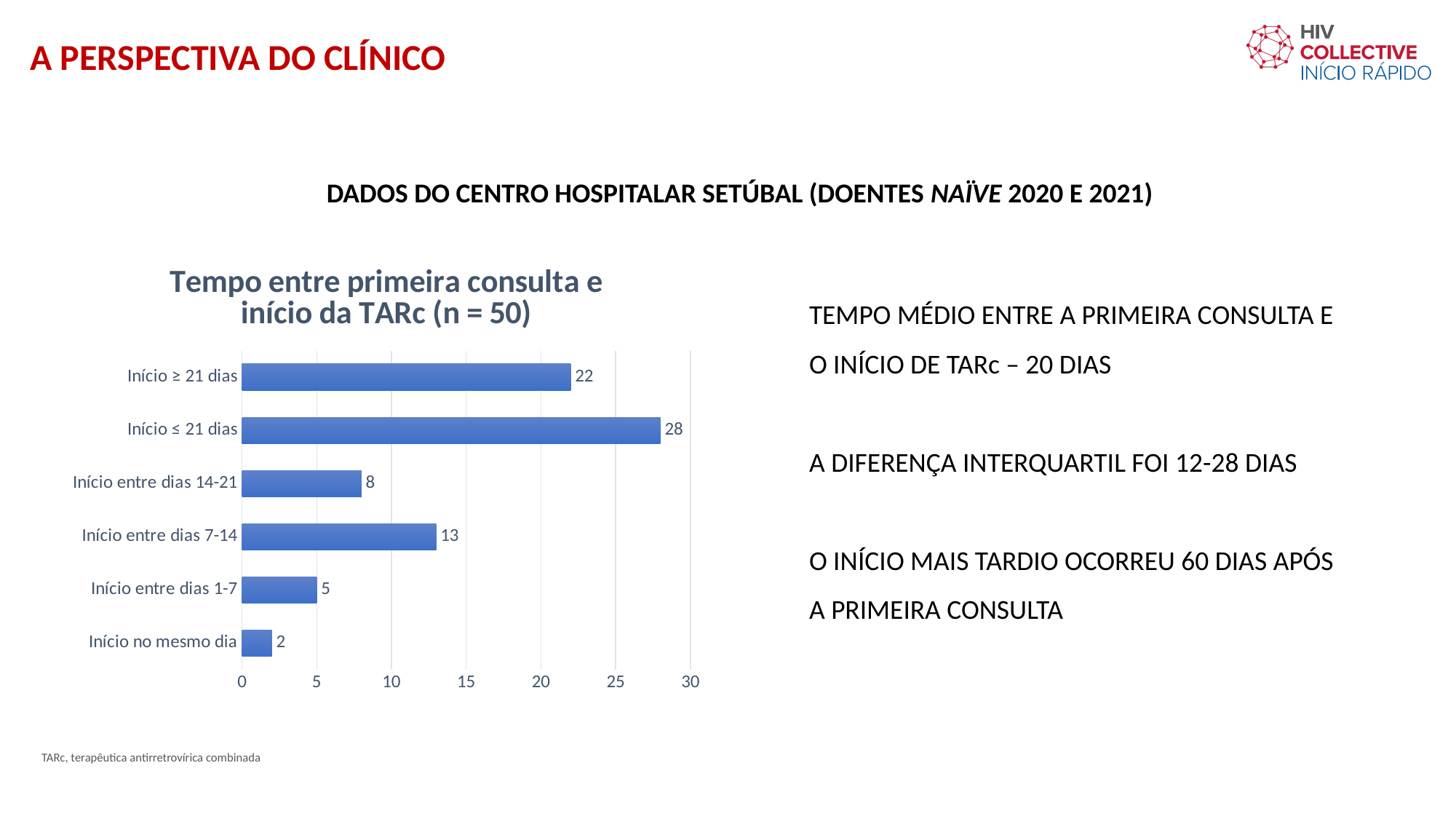
Which category has the lowest value? Início no mesmo dia How many categories are shown in the chart? 6 Which is larger, the value for "Início entre dias 7-14" or "Início entre dias 14-21"? Início entre dias 7-14 What is the value for "Início no mesmo dia"? 2 Is the value for "Início ≥ 21 dias" greater or less than 20? greater What is the value for "Início entre dias 14-21"? 8 Which category has the highest value? Início ≤ 21 dias What is the difference between the values for "Início ≤ 21 dias" and "Início ≥ 21 dias"? 6 What is the value for "Início entre dias 7-14"? 13 What is the title of the chart? Tempo entre primeira consulta e início da TARc (n = 50) What kind of chart is shown on the slide? Bar chart What is the value for "Início ≤ 21 dias"? 28